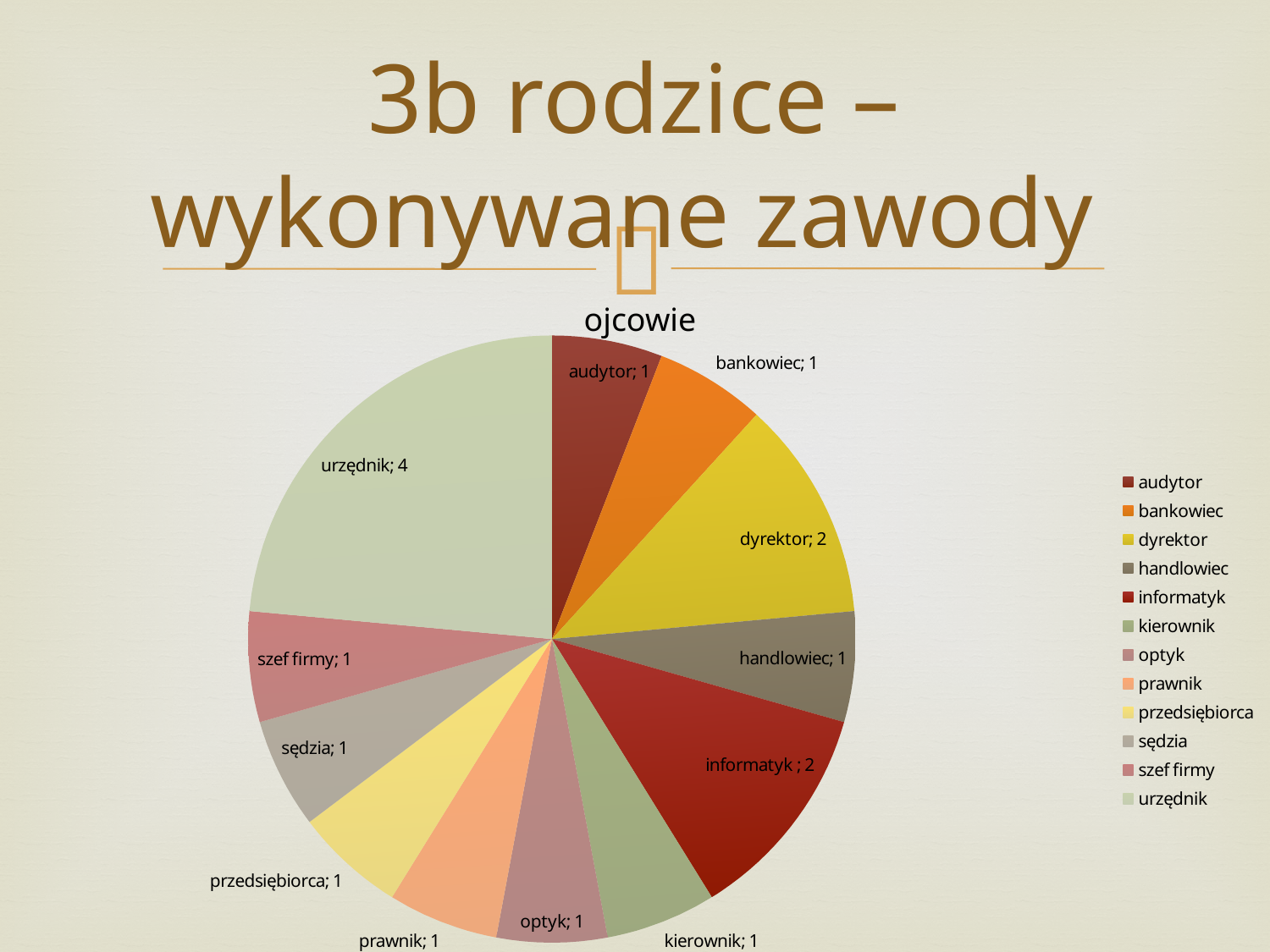
Which is larger in the ojcowie pie chart, the value for informatyk or the value for handlowiec? informatyk What is the total of all values in the ojcowie pie chart? 17 Which category has the largest slice in the ojcowie pie chart? urzędnik What is the title of the chart on the slide? ojcowie How many entries does the legend of the ojcowie pie chart list? 12 What is the difference between the values for urzędnik and dyrektor in the ojcowie pie chart? 2 What kind of chart is shown on the slide? pie chart What is the value for dyrektor in the ojcowie pie chart? 2 What is the value for szef firmy in the ojcowie pie chart? 1 What is the value for urzędnik in the ojcowie pie chart? 4 How many categories are shown in the ojcowie pie chart? 12 What is the value for informatyk in the ojcowie pie chart? 2